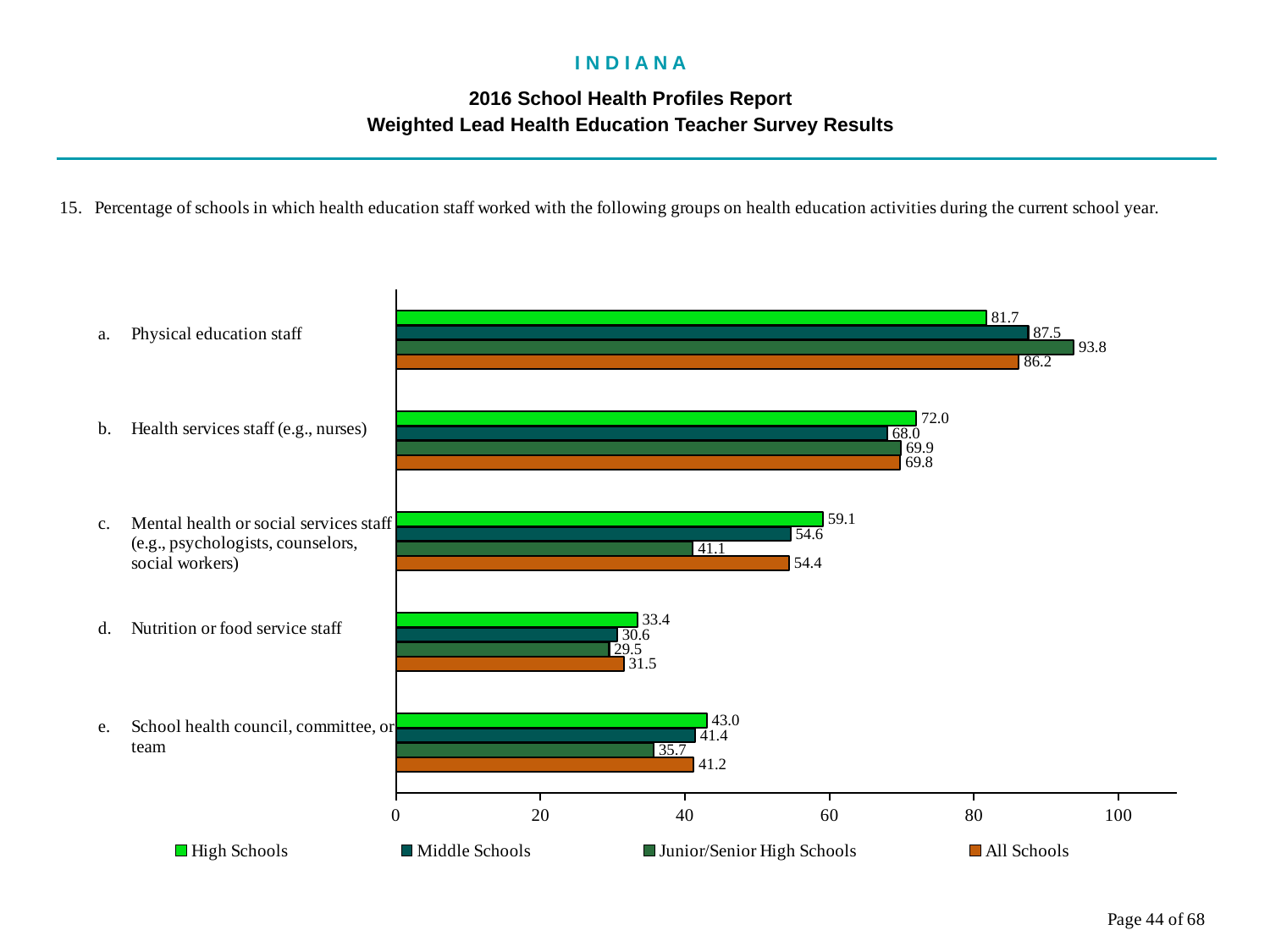
What is the difference between the High Schools and Junior/Senior High Schools values for Mental health or social services staff? 18.0 What is the value for Junior/Senior High Schools for School health council, committee, or team? 35.7 Which category has the lowest value for All Schools? Nutrition or food service staff Which category has the highest value for High Schools? Physical education staff How many categories are shown on the chart? 5 What is the value for All Schools for Mental health or social services staff? 54.4 How many series does the legend list? 4 What kind of chart is shown on the slide? Bar chart What is the value for Middle Schools for Nutrition or food service staff? 30.6 Which is larger for Health services staff: the High Schools value or the Middle Schools value? High Schools Which series is shown in orange in the legend? All Schools What is the value for Junior/Senior High Schools for Physical education staff? 93.8